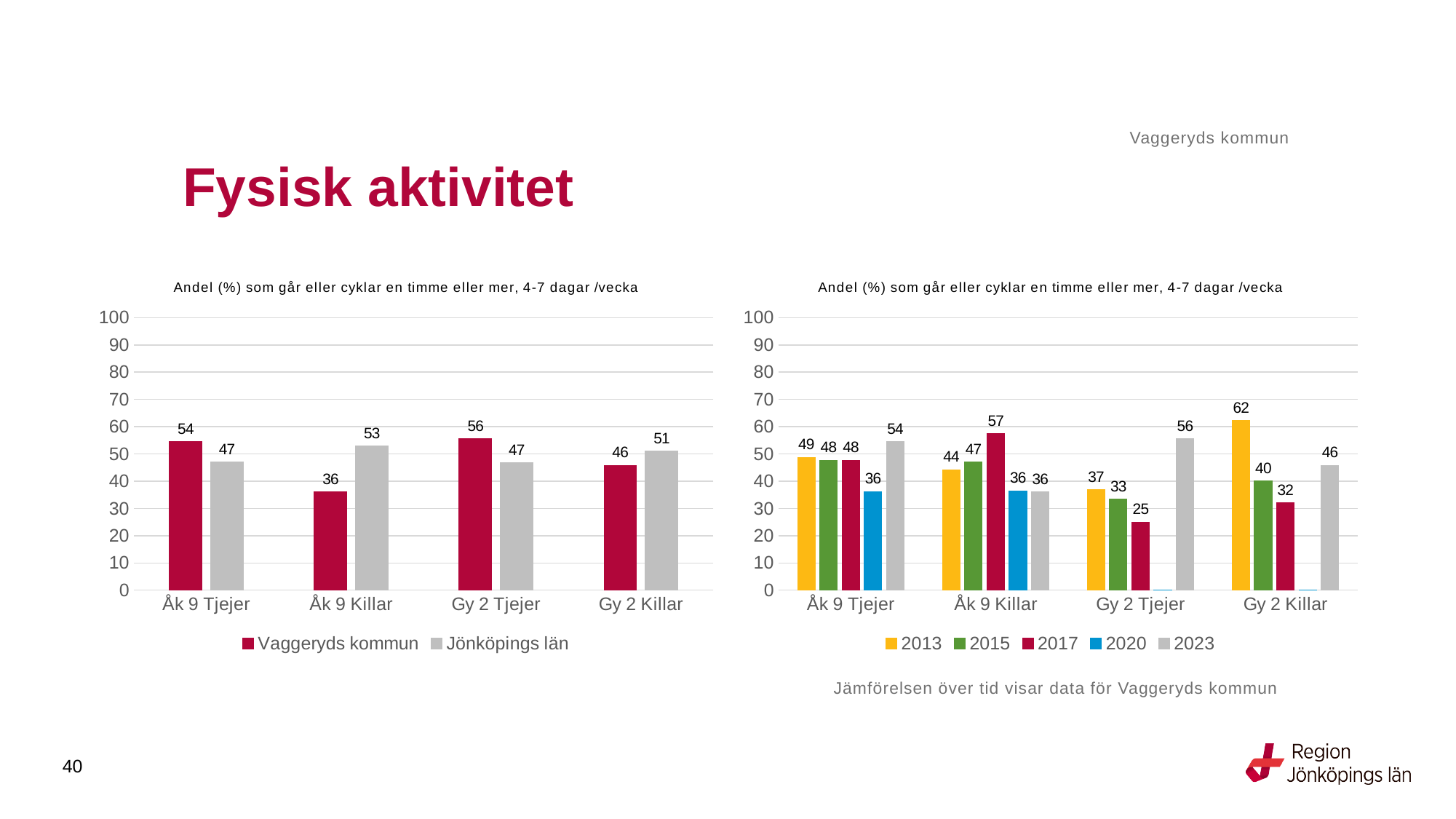
In the left chart, what is the value for Vaggeryds kommun for Åk 9 Killar? 36 What kind of chart is the right chart? Bar chart In the left chart, what is the value for Jönköpings län for Gy 2 Killar? 51 In the left chart, which is larger for Åk 9 Tjejer: Vaggeryds kommun or Jönköpings län? Vaggeryds kommun In the left chart, which category has the highest value for Vaggeryds kommun? Gy 2 Tjejer In the right chart, what is the value for 2017 for Åk 9 Killar? 57 How many series does the legend of the left chart list? 2 In the right chart, which category has the lowest value for 2017? Gy 2 Tjejer In the left chart, what is the difference between Vaggeryds kommun and Jönköpings län for Åk 9 Killar? 17 In the right chart, what is the value for 2013 for Gy 2 Killar? 62 In the right chart, what is the difference between the 2013 and 2023 values for Gy 2 Tjejer? 19 How many series does the legend of the right chart list? 5